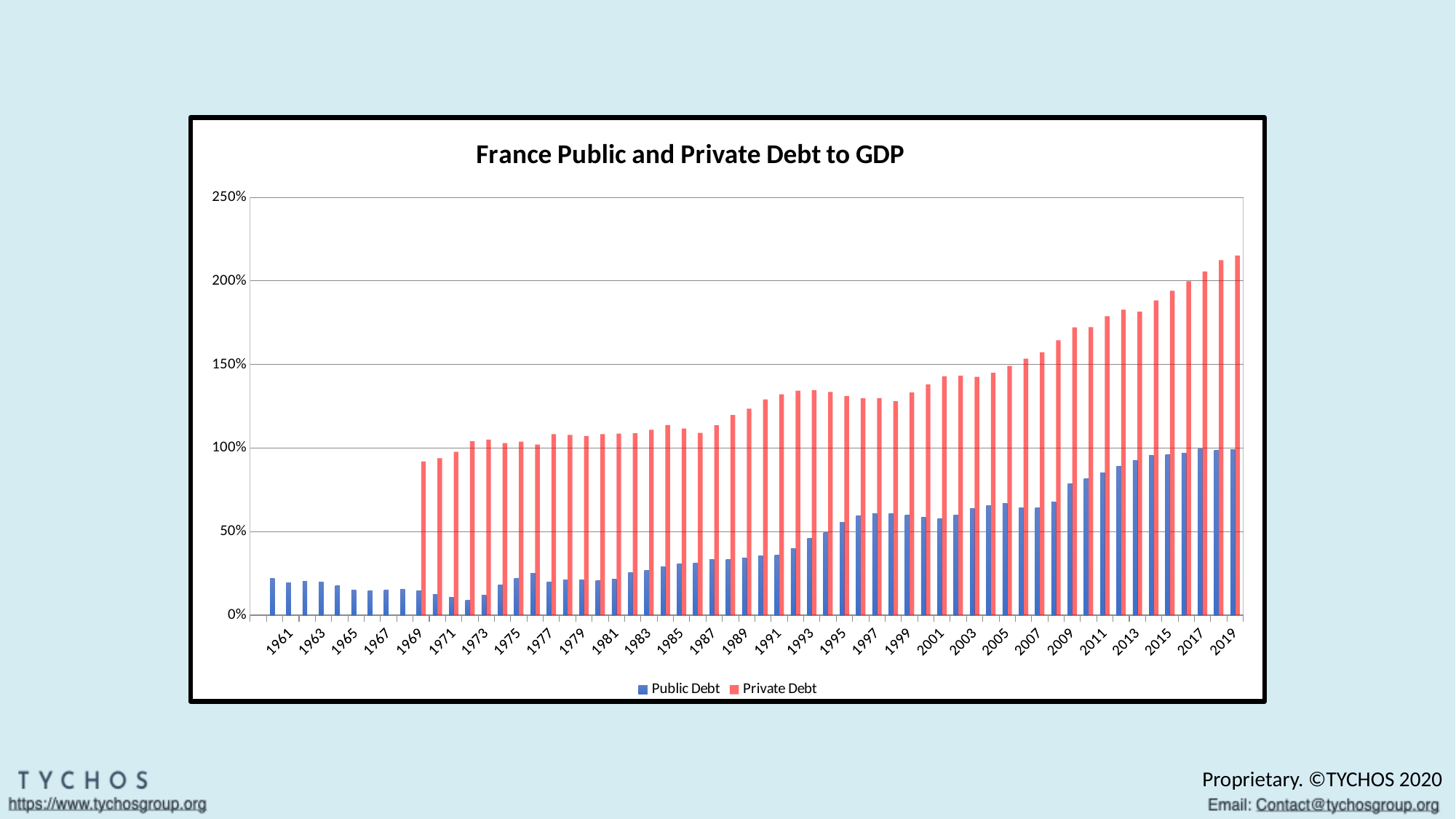
How many series does the legend list? 2 Is the Public Debt value for 2009 greater or less than 100%? less Which colour represents Private Debt in the chart? Red What is the title of the chart? France Public and Private Debt to GDP Is the Private Debt value for 1969 greater or less than 100%? less In 2019, which is larger: Public Debt or Private Debt? Private Debt In which year is Private Debt highest? 2019 Is the Public Debt value for 1971 greater or less than 50%? less Does Private Debt generally rise or fall from 1969 to 2019? Rise What kind of chart is shown on the slide? Bar chart